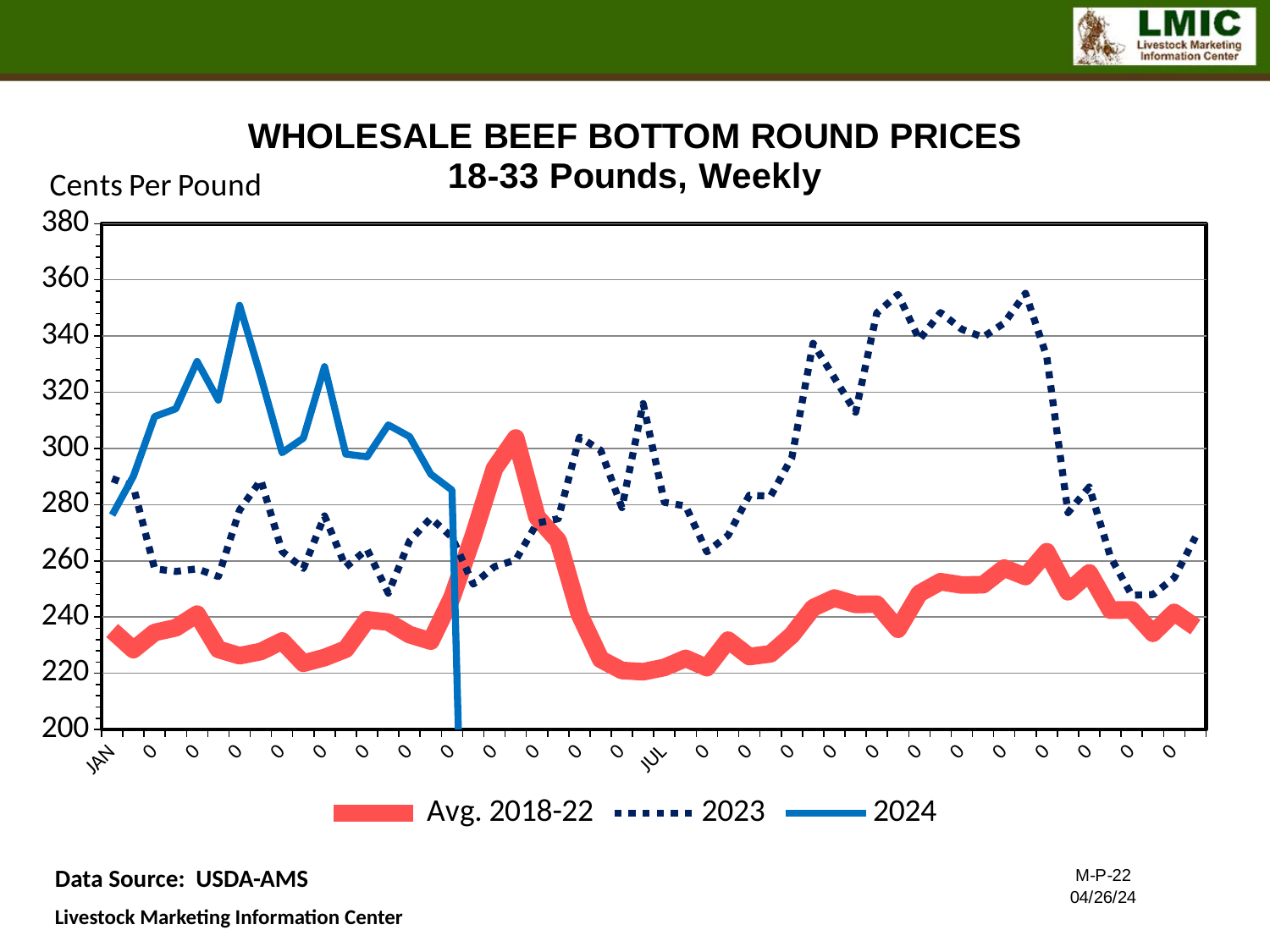
Is the highest value of the 2023 line greater or less than 340? greater Is the highest value of the Avg. 2018-22 line greater or less than 280? greater How many series does the legend list? 3 What kind of chart is shown on the slide? line chart Does the 2023 line rise or fall from JUL to its peak in the autumn? rise Is the value of the 2024 line at JAN greater or less than 300? less Does the 2024 line rise or fall from its peak to the end of its plotted data? fall In the first weeks of the year, which series is higher: 2024 or Avg. 2018-22? 2024 What are the three series listed in the legend? Avg. 2018-22, 2023, 2024 What unit is shown on the y axis of the chart? Cents Per Pound